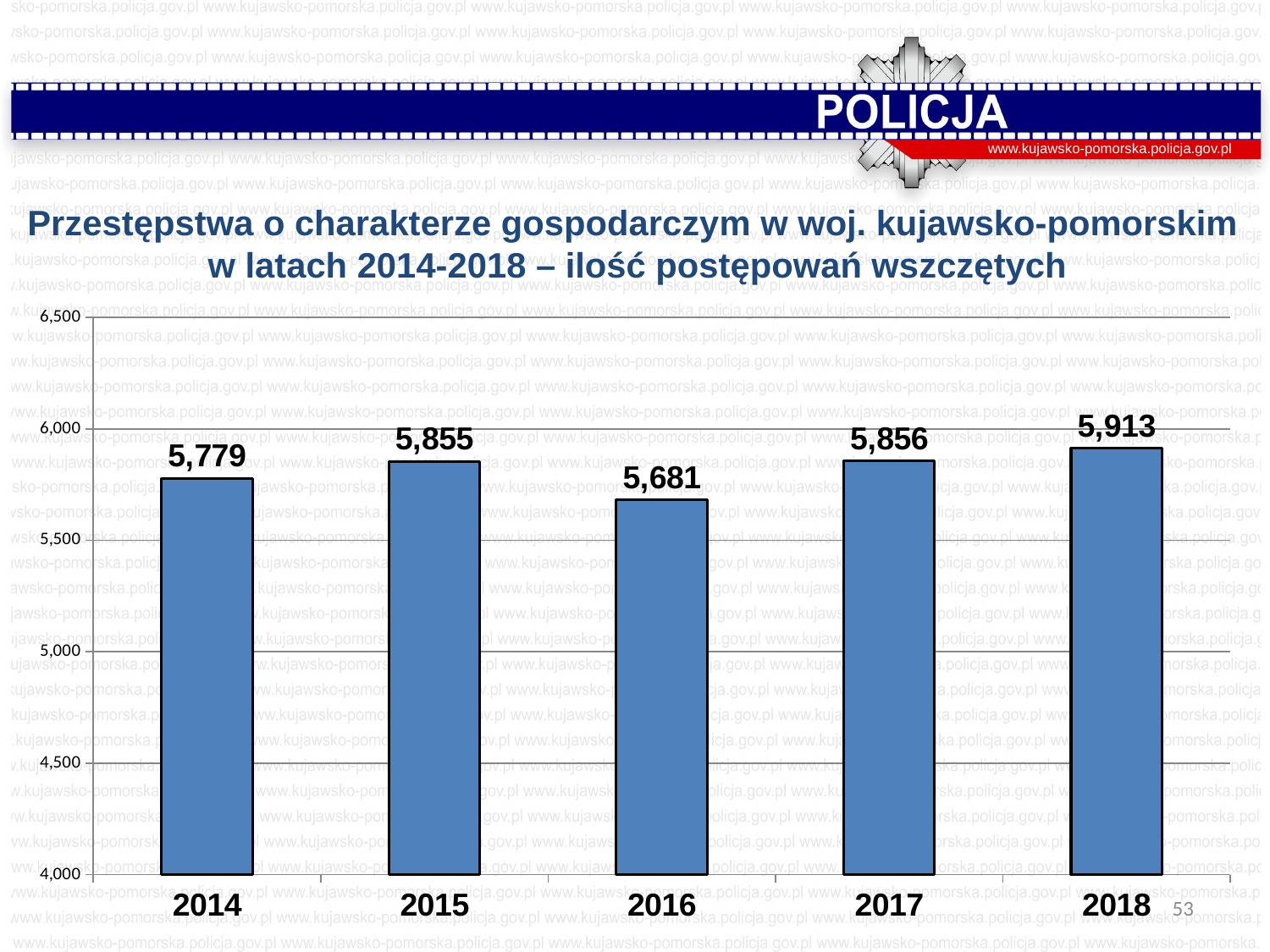
What is the value for 2016? 5,681 What is the value for 2018? 5,913 Is the value for 2017 greater or less than 6,000? less What is the difference between the values for 2015 and 2014? 76 What is the difference between the values for 2018 and 2016? 232 Which is larger, the value for 2014 or the value for 2016? 2014 Does the value rise or fall from 2015 to 2016? fall How many years are shown on the x axis? 5 What is the value for 2014? 5,779 What kind of chart is shown on the slide? bar chart Which year has the lowest value? 2016 Which year has the highest value? 2018